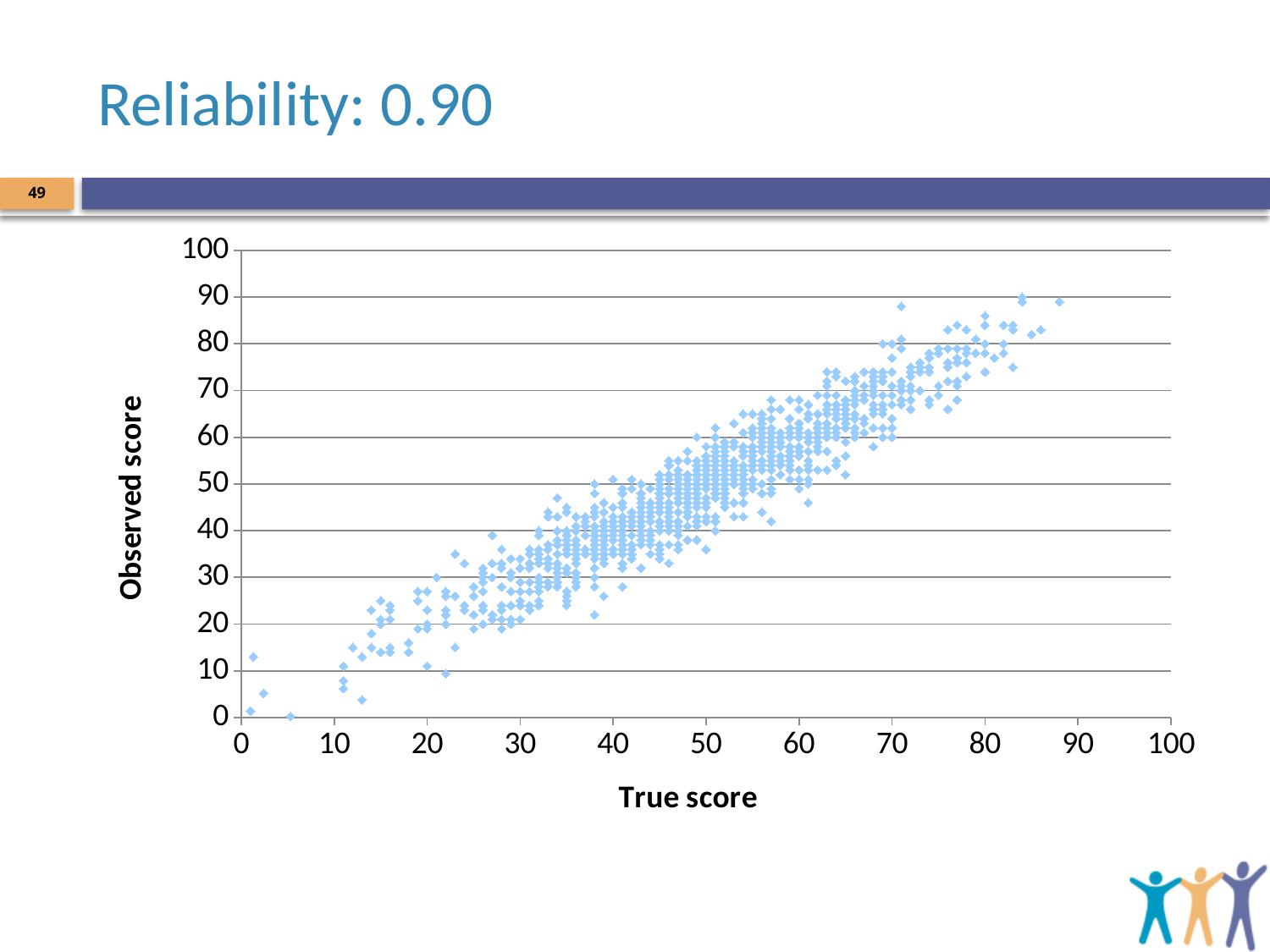
What is the label of the y axis? Observed score Is the largest true score plotted greater or less than 90? less What is the label of the x axis? True score Do the observed scores rise or fall as the true score increases along the x axis? rise Is the highest observed score plotted greater or less than 95? less What is the highest tick value shown on the x axis? 100 What kind of chart is shown on the slide? scatter plot Is the lowest observed score plotted greater or less than 10? less What is the highest tick value shown on the y axis? 100